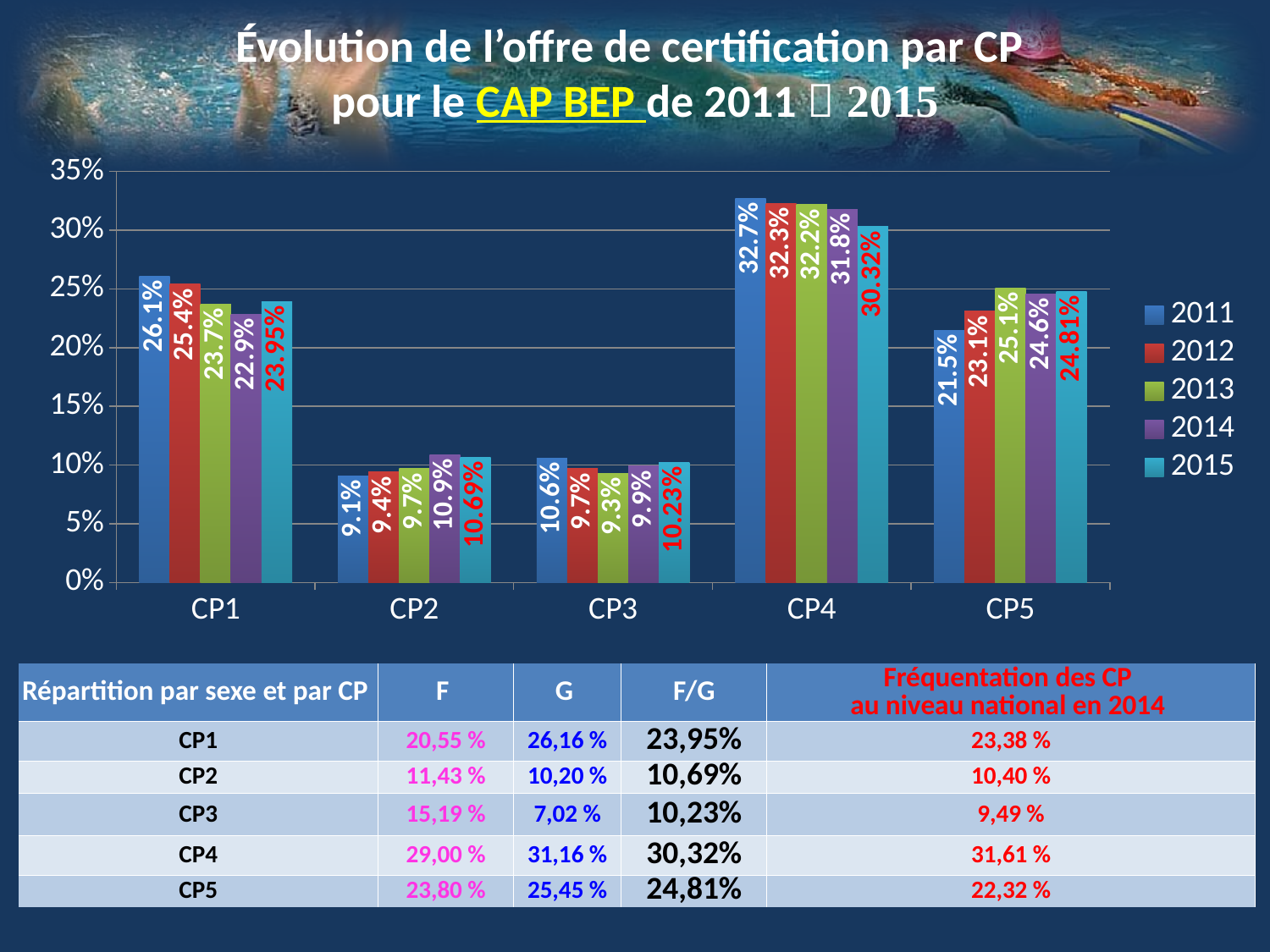
Which category has the highest value in 2015? CP4 Do the values for CP4 rise or fall from 2011 to 2015? fall How many series does the legend list? 5 What is the value for CP2 in 2015? 10.69% What is the difference between the 2011 and 2015 values for CP1? 2.15% What is the value for CP5 in 2013? 25.1% Which category has the lowest value in 2011? CP2 Which is larger for CP3: the 2011 value or the 2013 value? 2011 Is the value for CP5 in 2011 greater or less than 25%? less What kind of chart is shown on the slide? bar chart What is the value for CP4 in 2011? 32.7% How many categories are shown on the x axis? 5